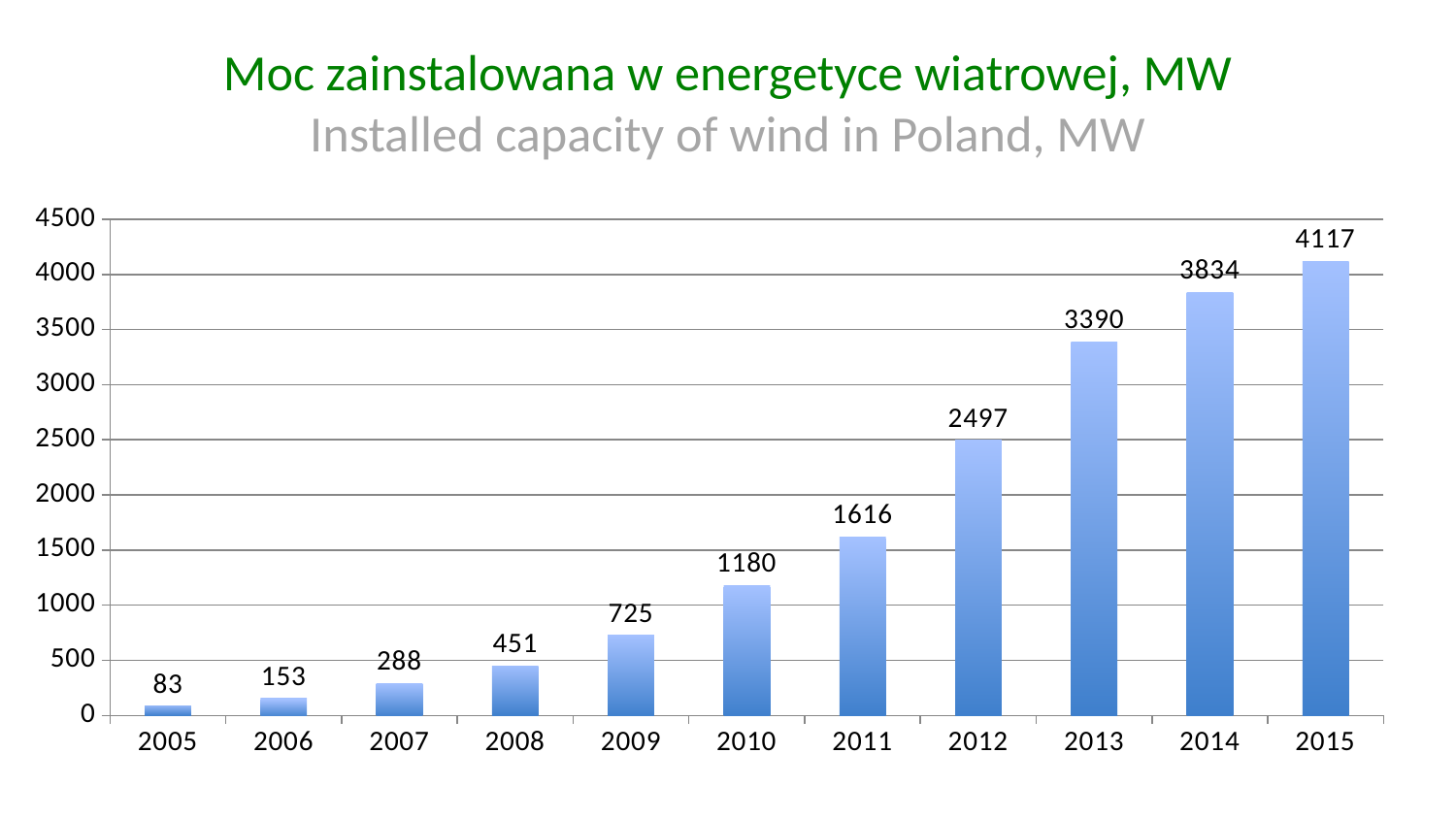
What is the installed wind capacity shown for 2010? 1180 Do the values rise or fall from 2005 to 2015? rise Which is larger, the value for 2008 or the value for 2009? 2009 What kind of chart is shown on the slide? bar chart What is the difference between the values for 2012 and 2011? 881 How many years are shown on the x axis? 11 Is the value for 2012 greater or less than 2000? greater Which year has the lowest installed capacity? 2005 What is the English subtitle of the chart? Installed capacity of wind in Poland, MW What is the difference between the values for 2015 and 2014? 283 What value is shown for 2013? 3390 Which year has the highest installed capacity? 2015